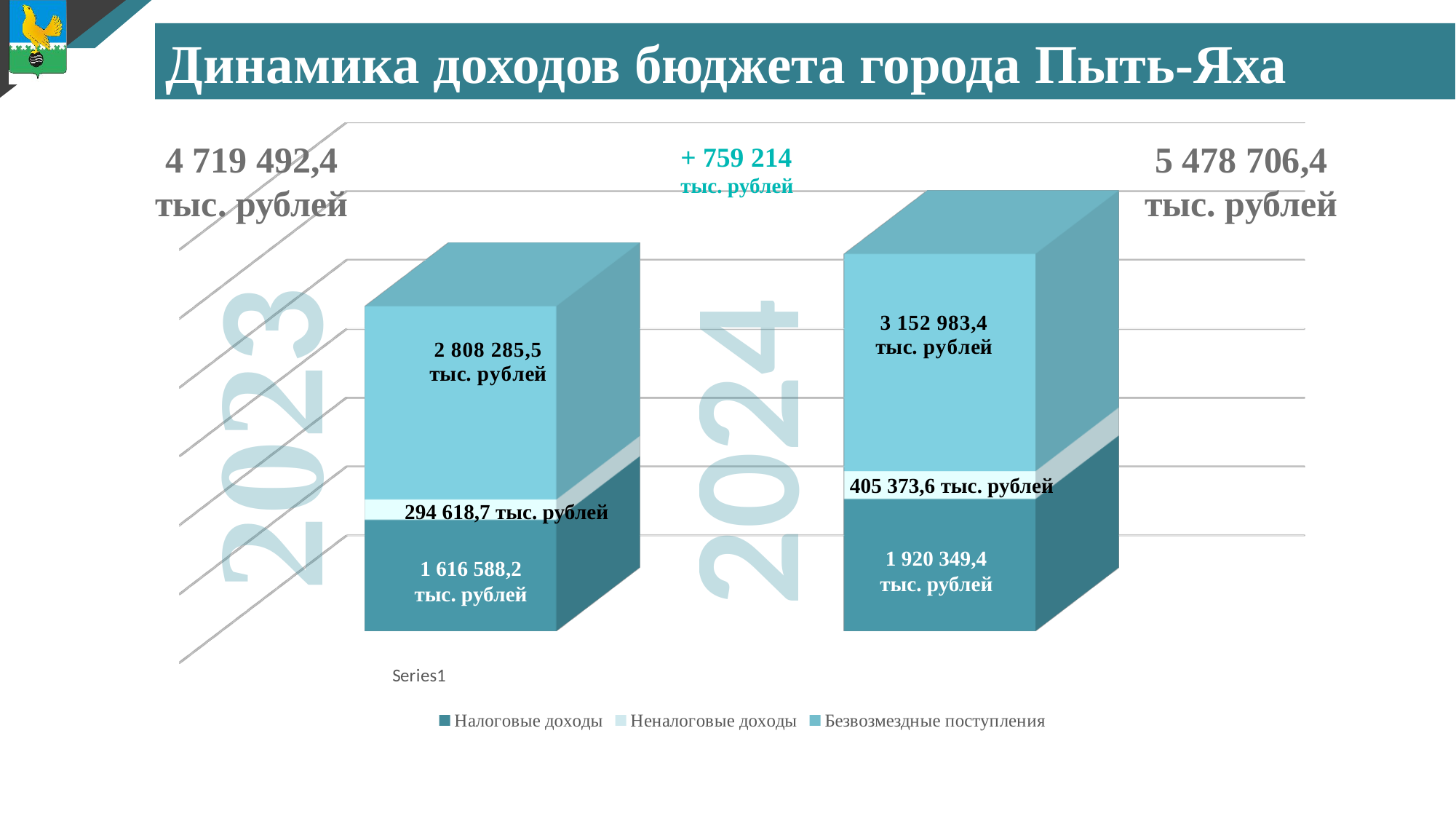
What is the total budget income shown for 2023? 4 719 492,4 тыс. рублей Which series has the smallest value in the 2023 bar? Неналоговые доходы How many series does the legend list? 3 By how much did total budget income change from 2023 to 2024, as shown on the slide? + 759 214 тыс. рублей What type of chart is shown on the slide? Bar chart (stacked) What is the total budget income shown for 2024? 5 478 706,4 тыс. рублей Which is larger: Налоговые доходы in 2023 or Налоговые доходы in 2024? 2024 What is the title of the chart? Динамика доходов бюджета города Пыть-Яха What is the value of Безвозмездные поступления for 2024? 3 152 983,4 тыс. рублей What is the value of Налоговые доходы for 2023? 1 616 588,2 тыс. рублей What is the value of Неналоговые доходы for 2024? 405 373,6 тыс. рублей What is the value of Безвозмездные поступления for 2023? 2 808 285,5 тыс. рублей